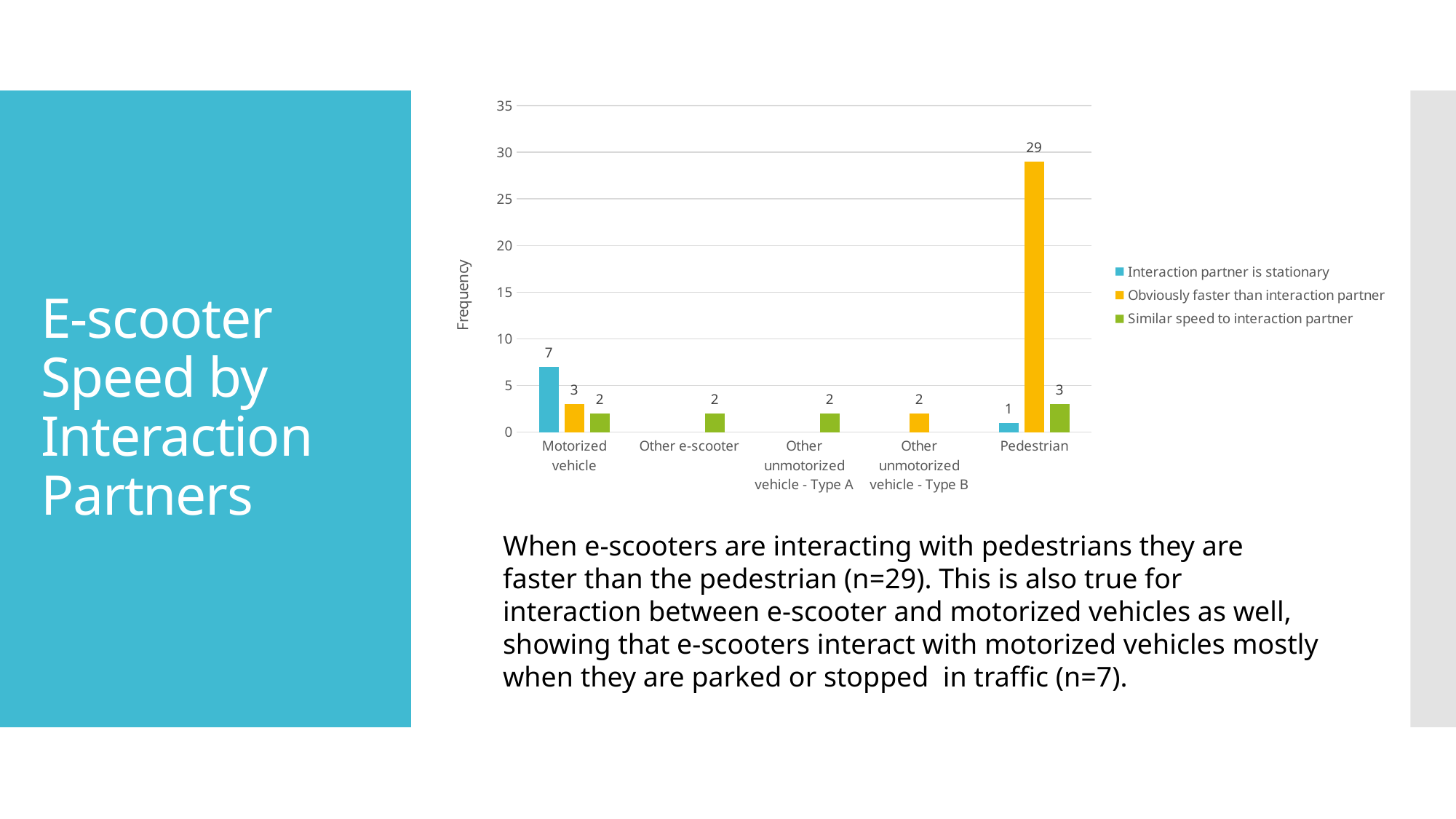
How many series does the legend list? 3 What is the difference between the 'Obviously faster than interaction partner' value for Pedestrian and for Motorized vehicle? 26 What is the value for 'Obviously faster than interaction partner' in the Other unmotorized vehicle - Type B category? 2 How many categories are shown on the x axis? 5 What is the value for 'Obviously faster than interaction partner' in the Pedestrian category? 29 What is the label of the y axis? Frequency Which category has the highest value for 'Interaction partner is stationary'? Motorized vehicle What kind of chart is shown on the slide? Bar chart What is the value for 'Similar speed to interaction partner' in the Other e-scooter category? 2 What is the value for 'Interaction partner is stationary' in the Motorized vehicle category? 7 Which category has the highest value for 'Obviously faster than interaction partner'? Pedestrian Which is larger: 'Interaction partner is stationary' for Motorized vehicle or for Pedestrian? Motorized vehicle